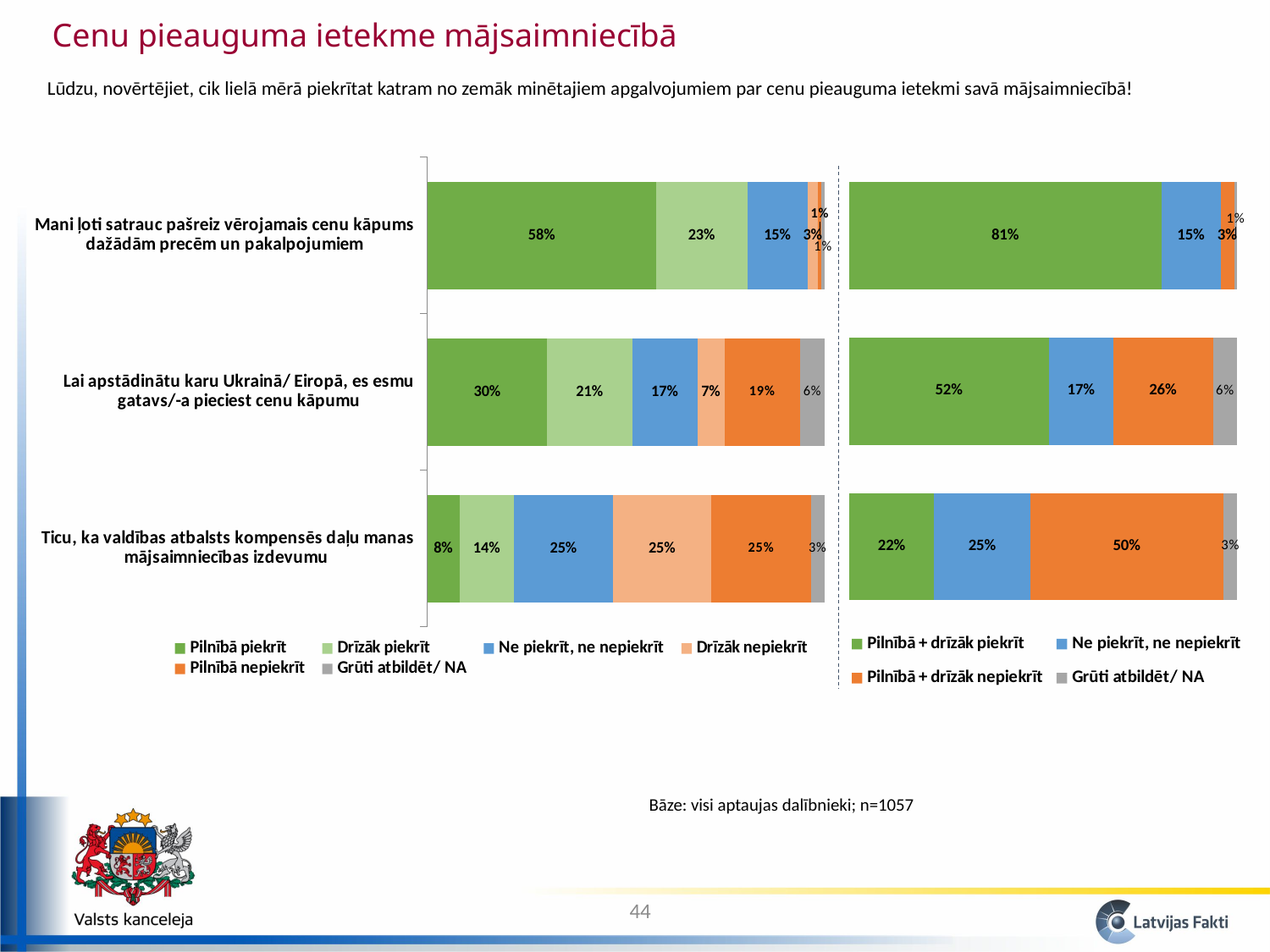
In the left chart, what is the "Pilnībā nepiekrīt" value for the statement "Ticu, ka valdības atbalsts kompensēs daļu manas mājsaimniecības izdevumu"? 25% In the right chart, which statement has the highest "Pilnībā + drīzāk piekrīt" value? Mani ļoti satrauc pašreiz vērojamais cenu kāpums dažādām precēm un pakalpojumiem In the left chart, which statement has the lowest "Pilnībā piekrīt" value? Ticu, ka valdības atbalsts kompensēs daļu manas mājsaimniecības izdevumu How many statements are shown in the left chart? 3 In the left chart, which statement has the larger "Drīzāk piekrīt" value: "Mani ļoti satrauc pašreiz vērojamais cenu kāpums..." or "Lai apstādinātu karu Ukrainā/ Eiropā..."? Mani ļoti satrauc pašreiz vērojamais cenu kāpums dažādām precēm un pakalpojumiem In the left chart, what percentage of respondents answered "Pilnībā piekrīt" to the statement "Mani ļoti satrauc pašreiz vērojamais cenu kāpums dažādām precēm un pakalpojumiem"? 58% In the right chart, what is the difference between the "Pilnībā + drīzāk nepiekrīt" values for "Ticu, ka valdības atbalsts kompensēs daļu manas mājsaimniecības izdevumu" and "Lai apstādinātu karu Ukrainā/ Eiropā, es esmu gatavs/-a pieciest cenu kāpumu"? 24 percentage points In the right chart, what is the "Grūti atbildēt/ NA" value for the statement "Lai apstādinātu karu Ukrainā/ Eiropā, es esmu gatavs/-a pieciest cenu kāpumu"? 6% In the right chart, what is the "Pilnībā + drīzāk piekrīt" value for the statement "Lai apstādinātu karu Ukrainā/ Eiropā, es esmu gatavs/-a pieciest cenu kāpumu"? 52% How many series does the legend of the left chart list? 6 What type of chart is the right chart? Stacked bar chart In the right chart's legend, what colour represents "Ne piekrīt, ne nepiekrīt"? Blue